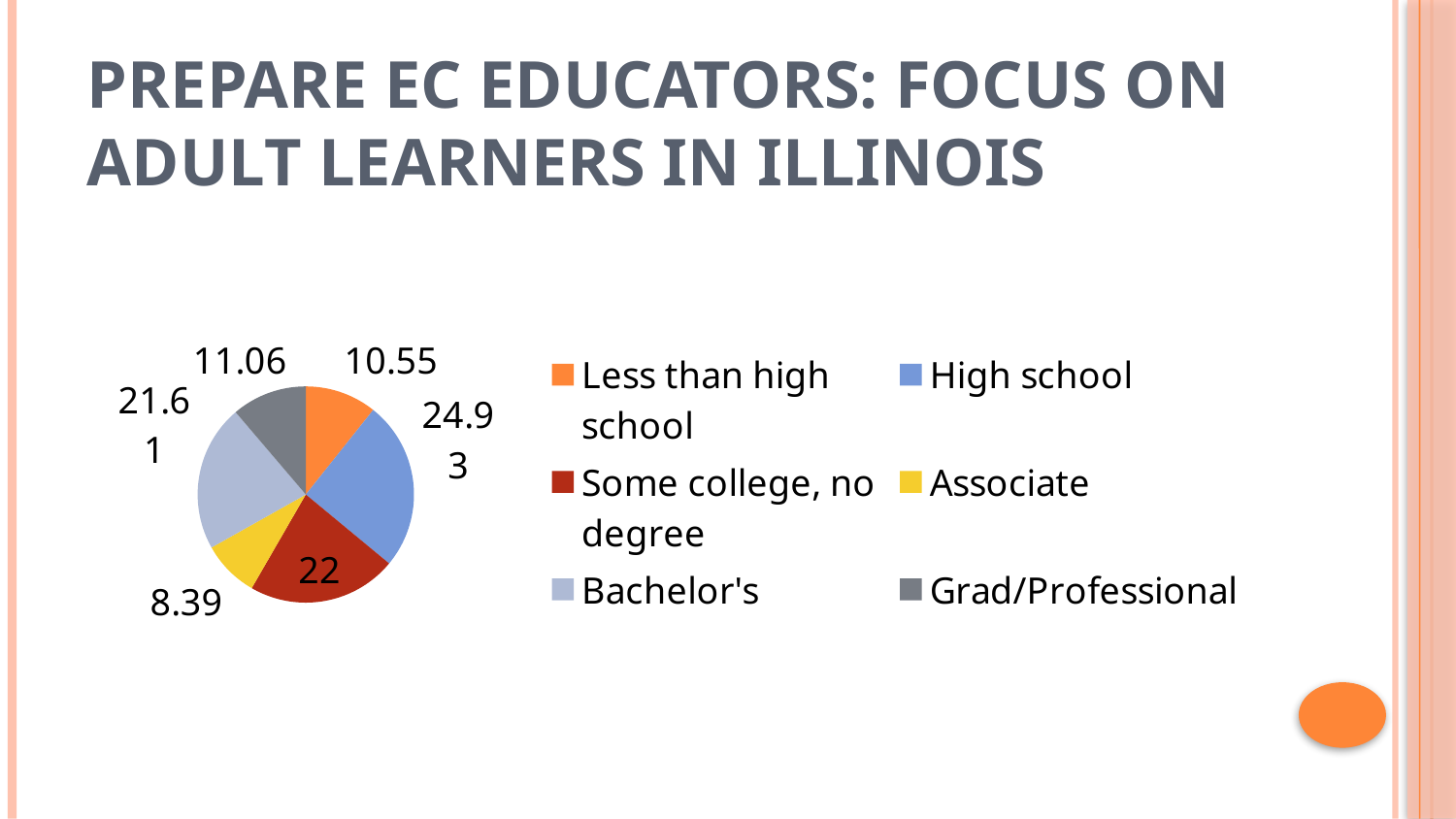
What is the value for Some college, no degree? 22 What is the value for High school in the pie chart? 24.93 Which category has the largest slice of the pie? High school What is the value for Associate? 8.39 What is the difference between the Grad/Professional value and the Less than high school value? 0.51 What is the value for Grad/Professional? 11.06 How many categories does the legend list? 6 What is the difference between the High school value and the Some college, no degree value? 2.93 What is the value for Bachelor's? 21.61 Which category has the smallest slice of the pie? Associate What kind of chart is shown on the slide? pie chart Which is larger, the value for High school or the value for Bachelor's? High school